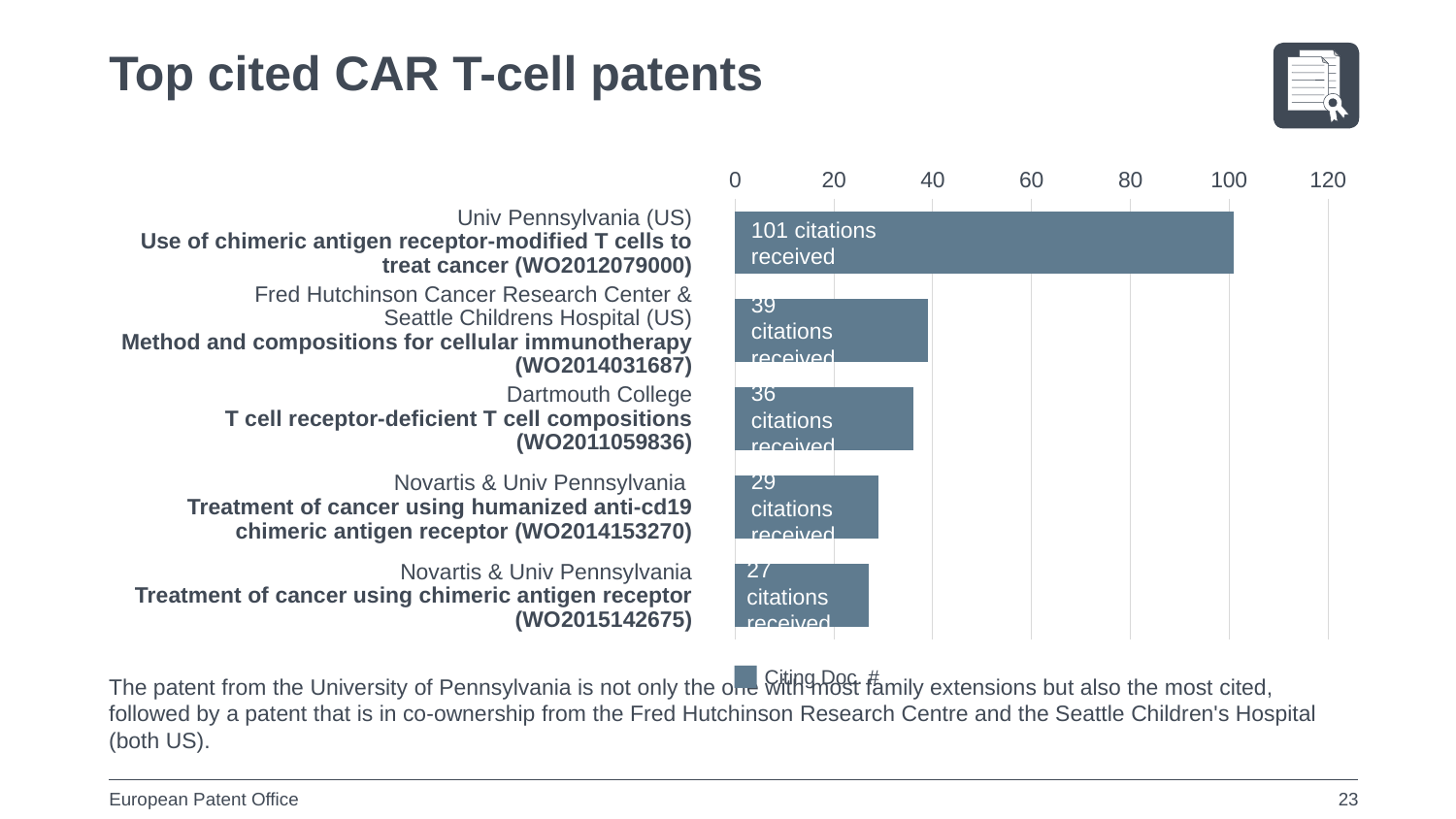
What is the legend entry of the chart? Citing Doc. # What kind of chart is shown on the slide? Bar chart How many citations did the Fred Hutchinson Cancer Research Center & Seattle Childrens Hospital patent WO2014031687 receive? 39 citations received Is the value for the Univ Pennsylvania patent WO2012079000 greater or less than 100? greater How many patents are shown in the chart? 5 How many citations did the Dartmouth College patent WO2011059836 receive? 36 citations received Which patent received the most citations? Univ Pennsylvania (US), WO2012079000 How many citations did the Univ Pennsylvania patent WO2012079000 receive? 101 citations received Which received more citations: the Dartmouth College patent WO2011059836 or the Novartis & Univ Pennsylvania patent WO2014153270? Dartmouth College patent WO2011059836 What is the difference in citations between the Univ Pennsylvania patent WO2012079000 and the Fred Hutchinson / Seattle Childrens Hospital patent WO2014031687? 62 Which patent received the fewest citations? Novartis & Univ Pennsylvania, WO2015142675 How many series does the legend list? 1